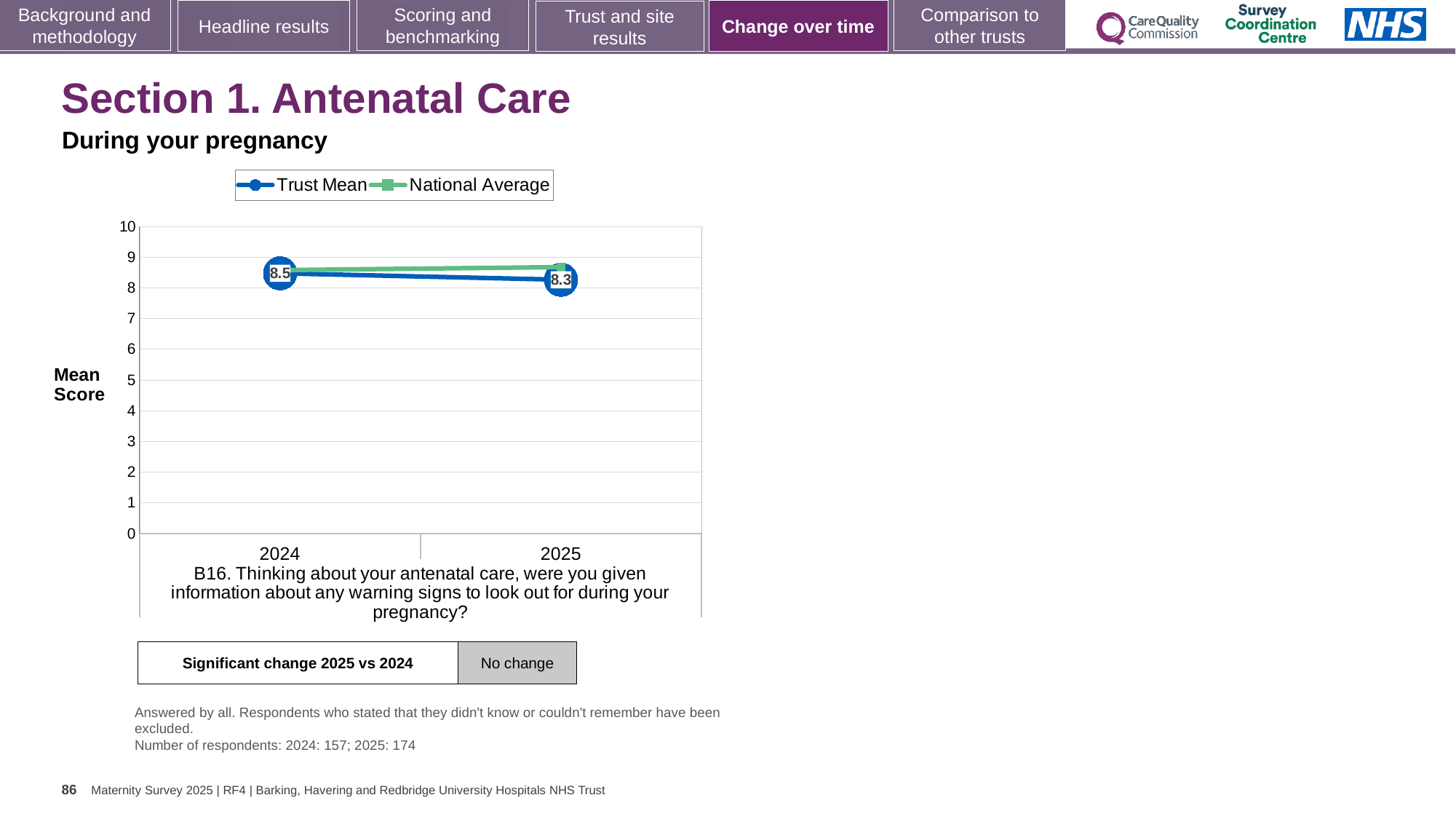
By how much did the Trust Mean score change from 2024 to 2025? 0.2 Does the Trust Mean rise or fall from 2024 to 2025? fall What is the Trust Mean score for 2025? 8.3 What are the two series named in the chart legend? Trust Mean and National Average What is the Trust Mean score for 2024? 8.5 In 2025, which series is higher, Trust Mean or National Average? National Average What kind of chart is shown on the slide? line chart What is the label on the y axis of the chart? Mean Score How many years are shown on the x axis of the chart? 2 How many series does the legend list? 2 Is the National Average value for 2025 greater or less than 8? greater Which year has the higher Trust Mean score, 2024 or 2025? 2024